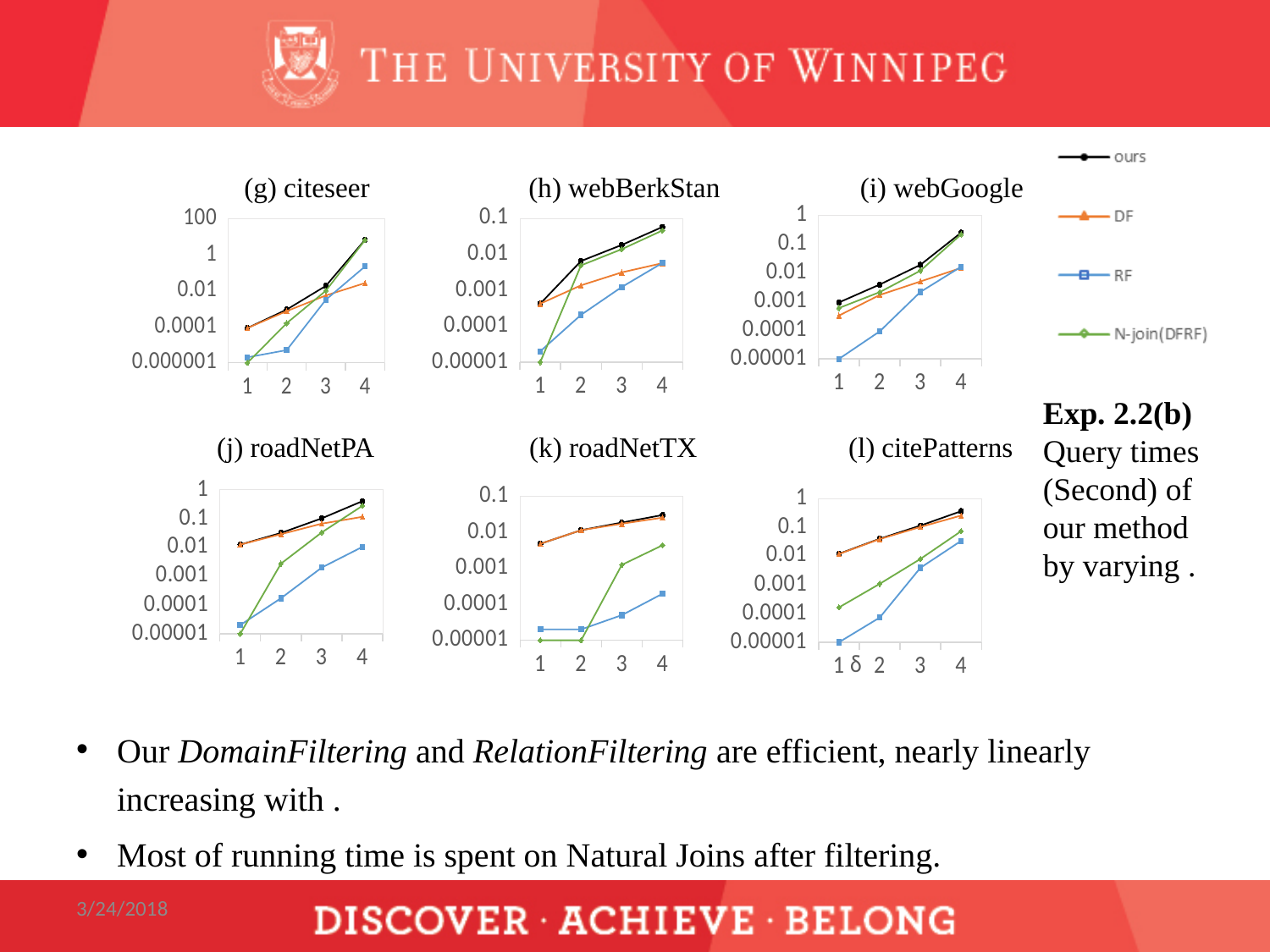
In the (j) roadNetPA chart, which is larger at x=4, 'ours' or RF? ours What kind of chart is (g) citeseer? line chart In the (k) roadNetTX chart, is the value of RF at x=4 greater or less than 0.0001? greater In the (k) roadNetTX chart, which series has the lowest value at x=4? RF In the (g) citeseer chart, which series has the lowest value at x=4? DF In the (j) roadNetPA chart, does the 'ours' series rise or fall as x goes from 1 to 4? rise What is the title of the chart in the top-right position of the grid? (i) webGoogle In the (h) webBerkStan chart, is the value of RF at x=1 greater or less than 0.0001? less In the (j) roadNetPA chart, is the value of 'ours' at x=4 greater or less than 0.1? greater How many series does the legend list for the charts? 4 How many x-axis points are plotted in the (j) roadNetPA chart? 4